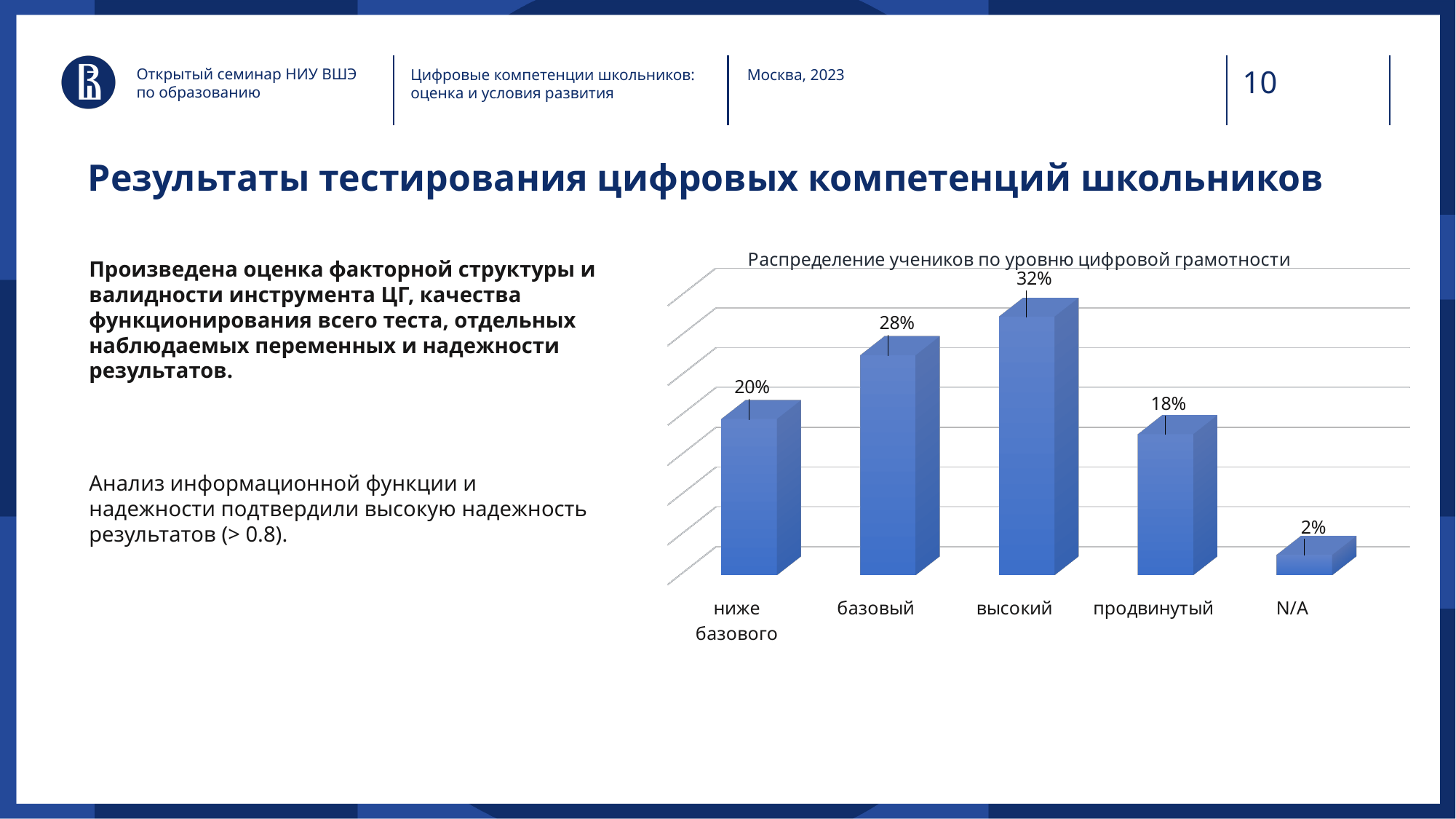
What kind of chart is shown on the slide? bar chart What is the title of the chart? Распределение учеников по уровню цифровой грамотности How many categories are shown on the x axis? 5 What is the value for the 'N/A' category? 2% Which category has the highest value? высокий What is the difference between the values for 'базовый' and 'ниже базового'? 8% What is the value for the 'базовый' category? 28% What is the value for 'продвинутый'? 18% Which is larger, the value for 'ниже базового' or the value for 'продвинутый'? ниже базового Which category has the lowest value? N/A What is the value for 'ниже базового'? 20% What is the difference between the values for 'высокий' and 'продвинутый'? 14%